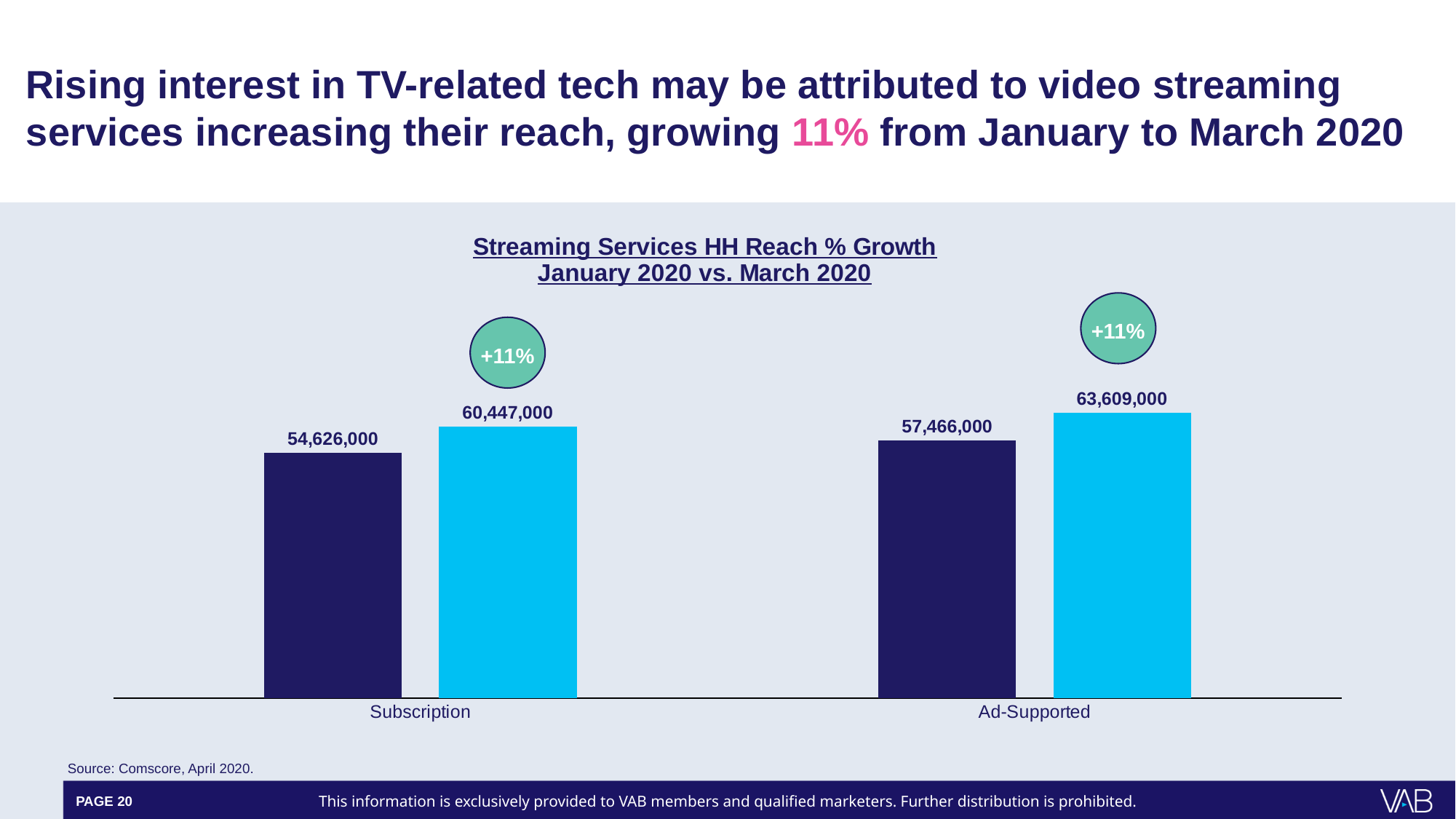
What is the value of the dark navy (first) bar for Ad-Supported? 57,466,000 What is the value of the dark navy (first) bar for Subscription? 54,626,000 What is the difference between the two Subscription bars? 5,821,000 What growth percentage is shown in the circle above the Ad-Supported bars? +11% Which bar on the chart has the lowest value? Subscription dark navy bar (54,626,000) What is the difference between the two Ad-Supported bars? 6,143,000 Which bar on the chart has the highest value? Ad-Supported light blue bar (63,609,000) What is the value of the light blue (second) bar for Ad-Supported? 63,609,000 How many categories are shown on the x axis? 2 What is the value of the light blue (second) bar for Subscription? 60,447,000 Which is larger: the dark navy bar for Ad-Supported or the light blue bar for Subscription? Light blue bar for Subscription What kind of chart is shown on the slide? Bar chart